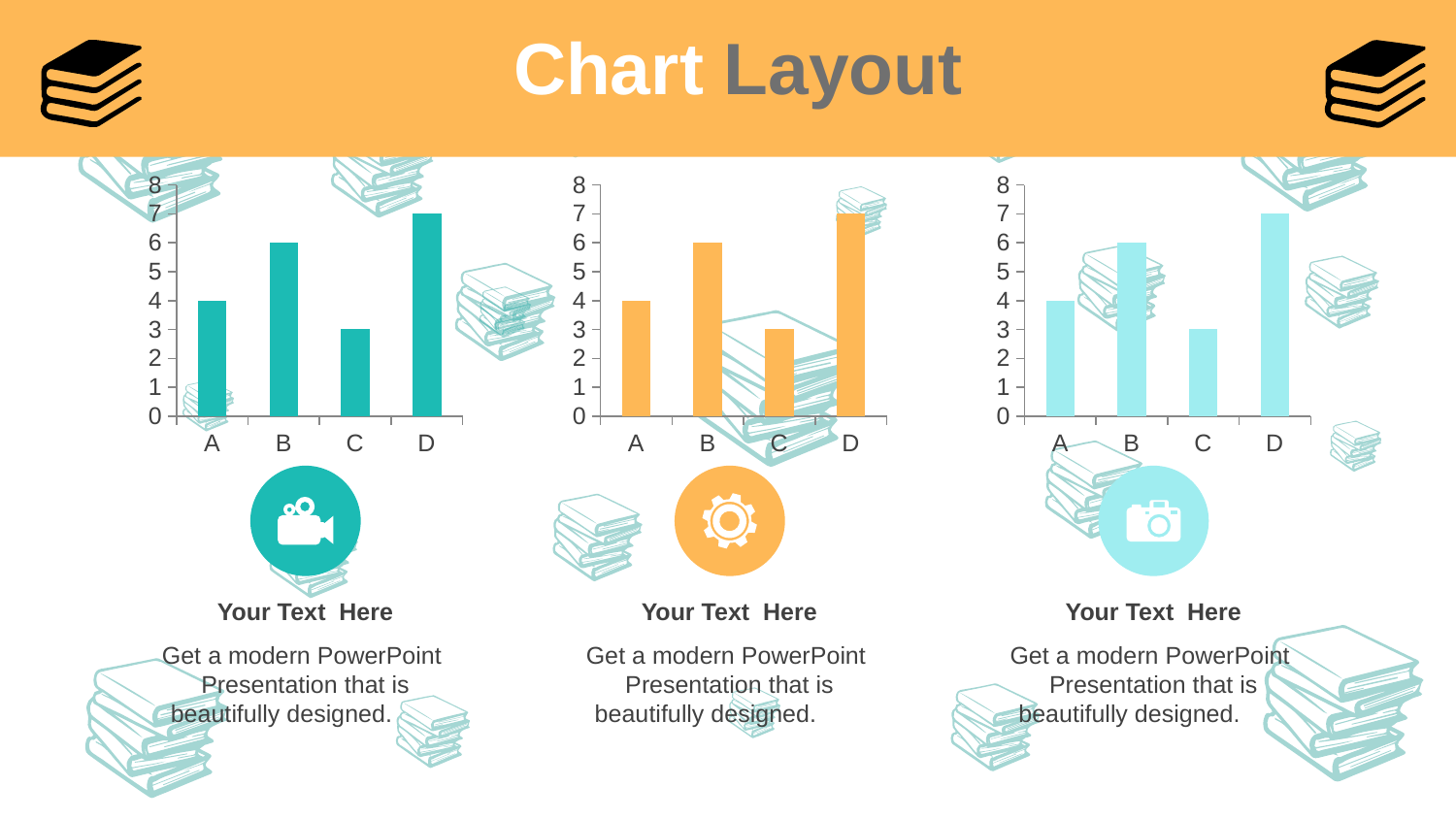
What kind of chart is the middle chart? bar chart In the middle chart, what is the value for category A? 4 In the left chart, what is the value for category B? 6 In the middle chart, is the value for D greater or less than 5? greater In the middle chart, which category has the lowest value? C In the right chart, what is the value for category C? 3 In the left chart, which is larger, the value for B or the value for C? B How many charts are shown on the slide? 3 What colour are the bars in the middle chart? orange In the left chart, which category has the highest value? D In the right chart, what is the difference between the values for D and A? 3 How many categories are shown on the x axis of the right chart? 4